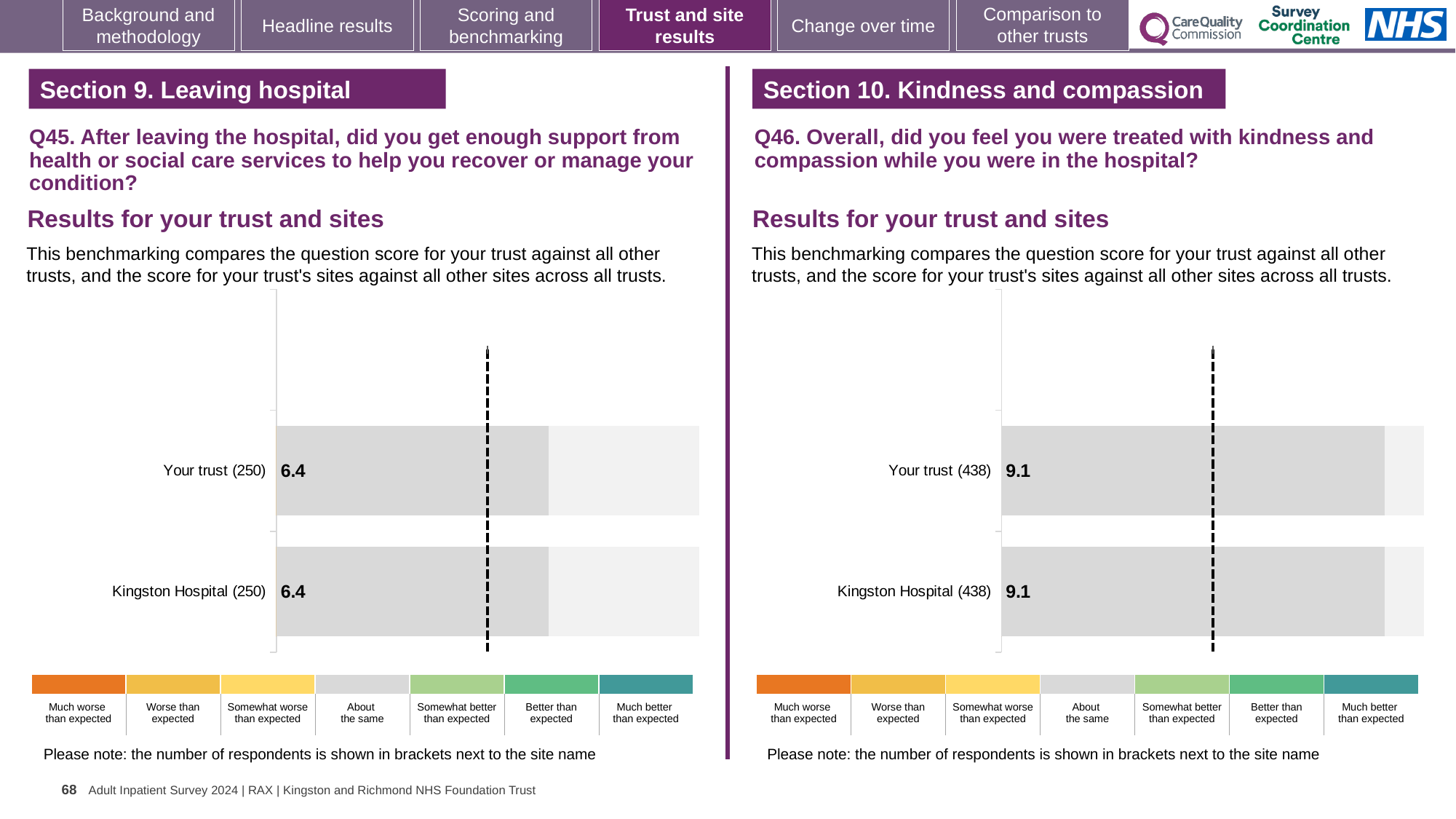
In the Q45 chart on the left, how many respondents are shown in brackets for Kingston Hospital? 250 In the Q46 chart on the right, what is the score for Kingston Hospital? 9.1 In the Q46 chart on the right, what is the score for Your trust? 9.1 How many bars are plotted in the Q45 chart on the left? 2 In the Q45 chart on the left, what is the score for Kingston Hospital? 6.4 In the Q46 chart on the right, what is the difference between the score for Your trust and the score for Kingston Hospital? 0 In the Q45 chart on the left, what is the score for Your trust? 6.4 In the Q46 chart on the right, how many respondents are shown in brackets for Your trust? 438 What kind of chart is the Q46 chart on the right? Bar chart How many bars are plotted in the Q46 chart on the right? 2 In the Q45 chart on the left, what is the difference between the score for Your trust and the score for Kingston Hospital? 0